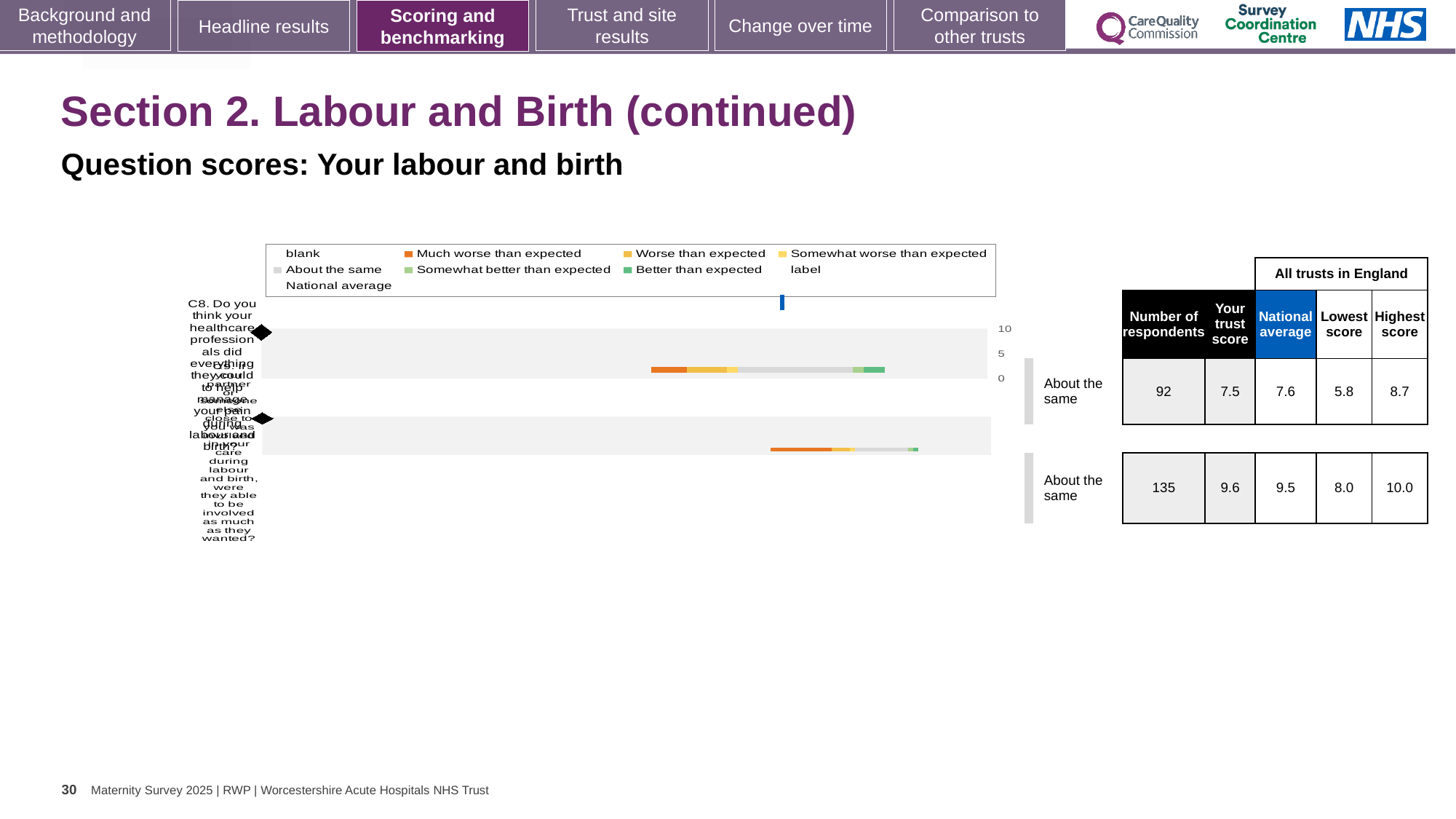
For the first question row (C8), what is the difference between the highest score (8.7) and the lowest score (5.8) across all trusts in England? 2.9 In the chart legend, what colour is used for 'Much worse than expected'? orange For the first question row (C8), which is larger: the trust score or the national average? national average What kind of chart is shown on the slide? bar chart How many question rows are plotted in the chart? 2 In the table beside the chart, what is 'Your trust score' for the first question row (C8)? 7.5 In the table beside the chart, what is the highest score among all trusts in England for the second question row? 10.0 What benchmark category is shown next to the chart for both question rows? About the same In the table beside the chart, what is the number of respondents for the first question row (C8)? 92 In the table beside the chart, what is the national average for the second question row? 9.5 In the table beside the chart, what is the number of respondents for the second question row? 135 In the chart legend, what does the blue vertical line represent? National average